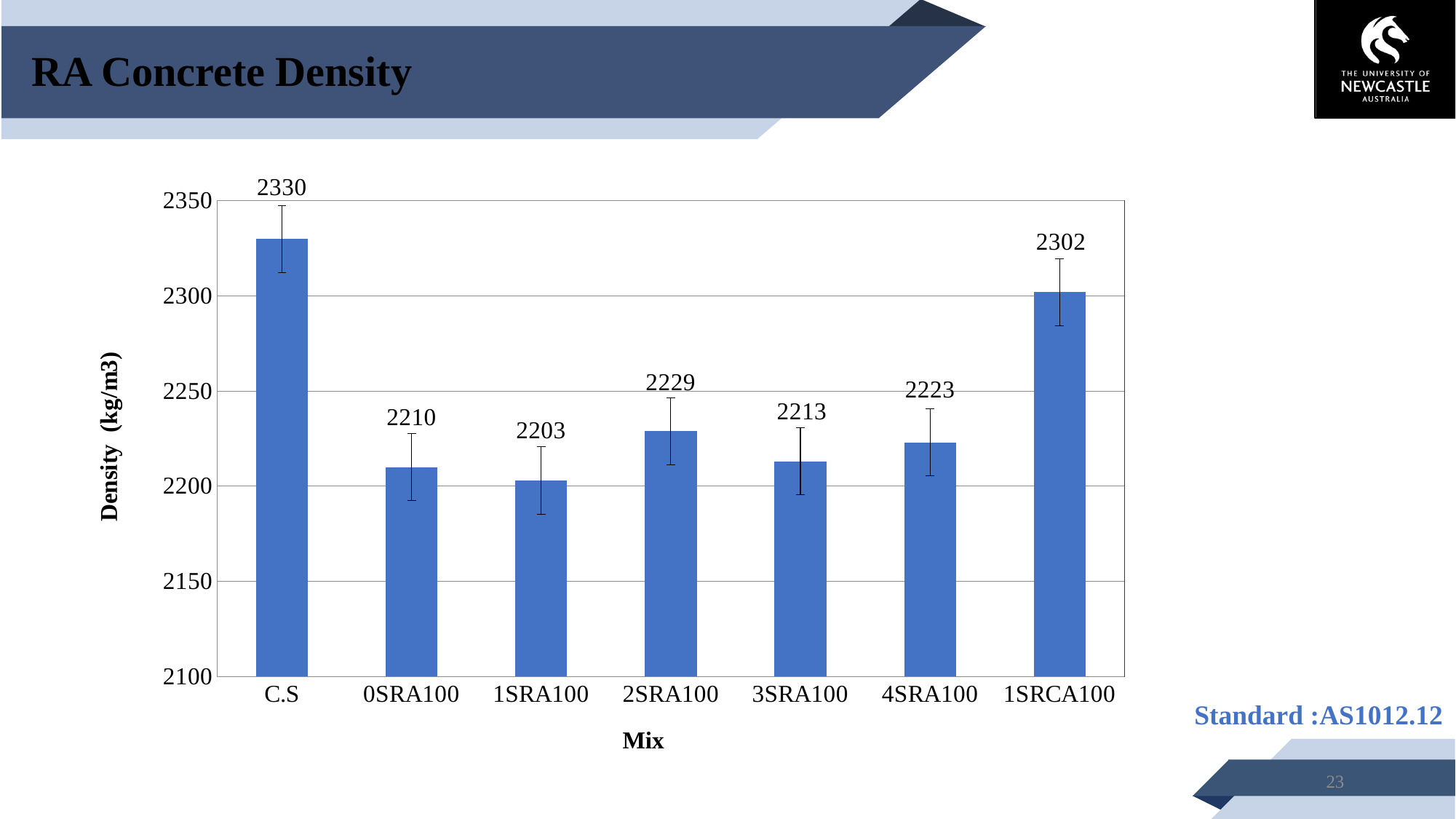
What is the density value for the 1SRCA100 mix? 2302 Which mix has the lowest density? 1SRA100 Which has a higher density, 0SRA100 or 4SRA100? 4SRA100 What is the label of the y axis? Density (kg/m3) Which mix has the highest density? C.S What is the difference in density between C.S and 1SRCA100? 28 What is the difference in density between 2SRA100 and 1SRA100? 26 What is the density value for the 2SRA100 mix? 2229 What kind of chart is shown on the slide? bar chart What is the density value for the C.S mix? 2330 Is the density value for 3SRA100 greater or less than 2250? less How many mixes are shown on the x axis? 7